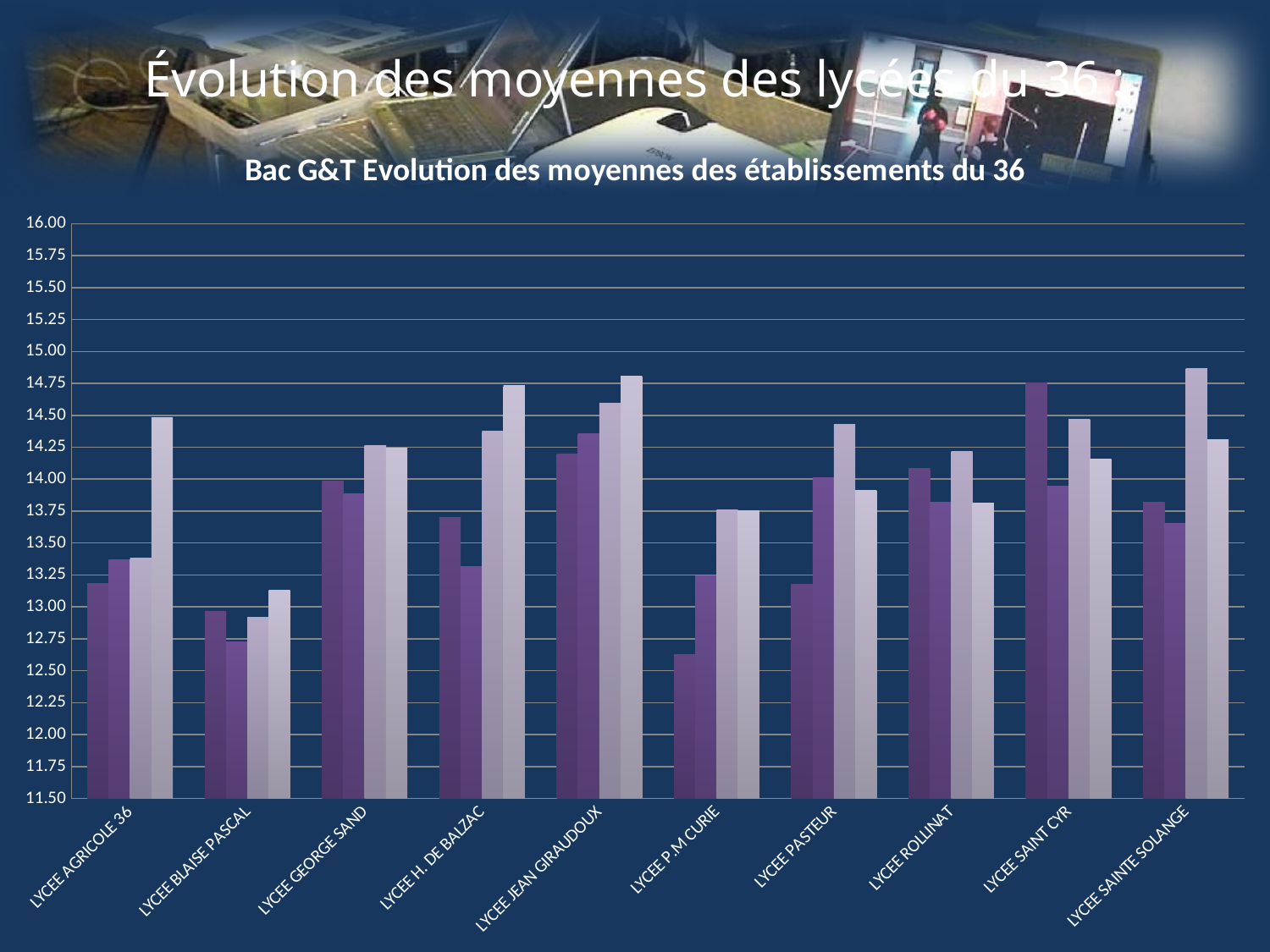
Is the value of the lightest (rightmost) bar for LYCEE SAINTE SOLANGE greater or less than 14.75? less What is the highest value shown on the vertical axis? 16.00 How many bars are plotted for each lycée? 4 How many lycées (categories) are shown on the x axis? 10 What kind of chart is shown on the slide? bar chart Which is higher: the lightest (rightmost) bar for LYCEE AGRICOLE 36 or the lightest (rightmost) bar for LYCEE BLAISE PASCAL? LYCEE AGRICOLE 36 Is the value of the darkest (leftmost) bar for LYCEE P.M CURIE greater or less than 13.00? less Do the four bars for LYCEE JEAN GIRAUDOUX rise or fall from left to right? rise Which lycée has the lowest darkest (leftmost) bar? LYCEE P.M CURIE What is the title of the chart? Bac G&T Evolution des moyennes des établissements du 36 Is the value of the second bar for LYCEE BLAISE PASCAL greater or less than 13.00? less